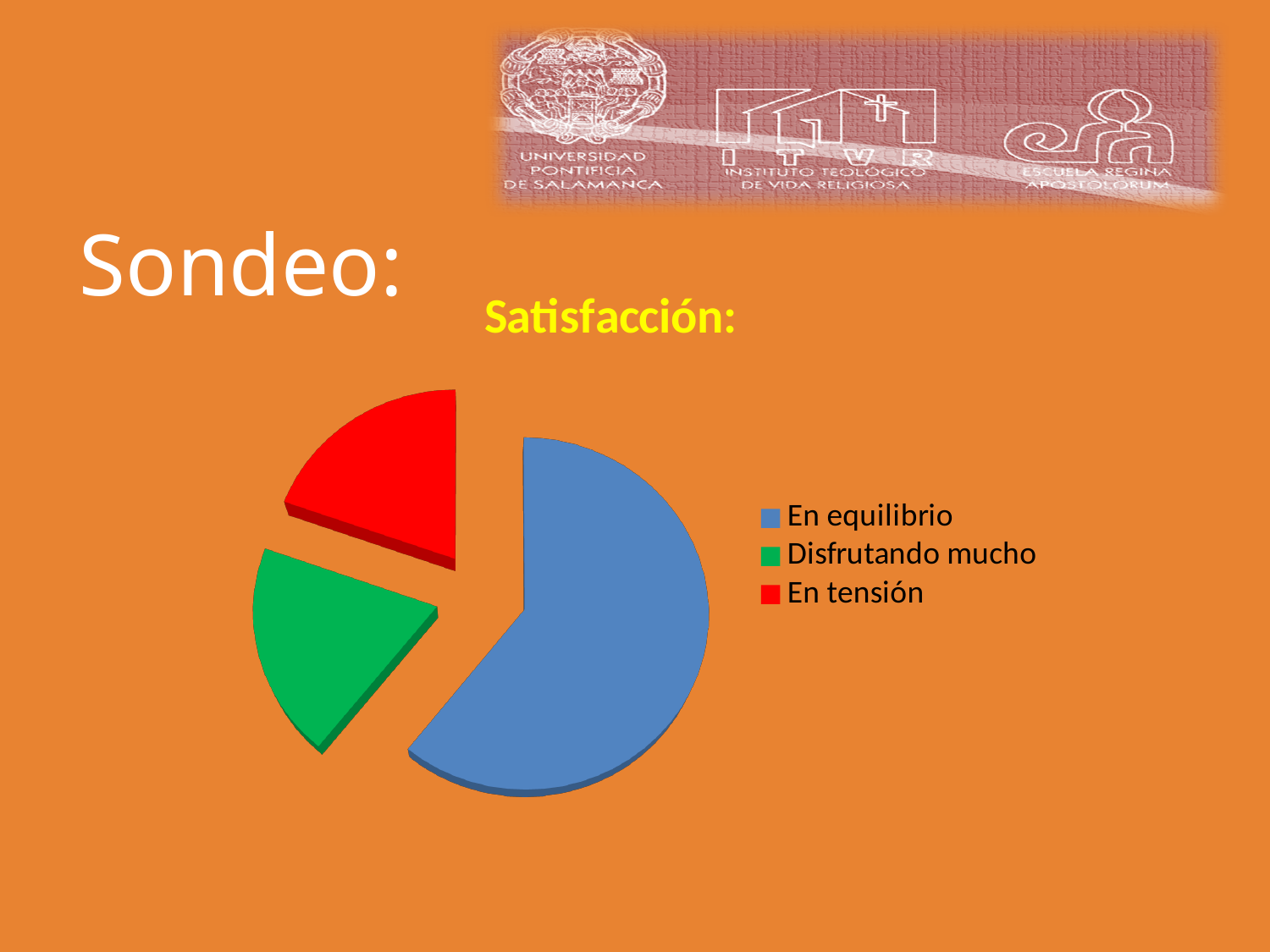
Which category has the largest slice of the pie? En equilibrio Which slice is larger, En equilibrio or Disfrutando mucho? En equilibrio What colour is the slice for En tensión? red What is the title of the chart? Satisfacción: How many slices does the pie chart have? 3 Which slice is larger, En equilibrio or En tensión? En equilibrio What kind of chart is shown on the slide? pie chart How many entries does the chart legend list? 3